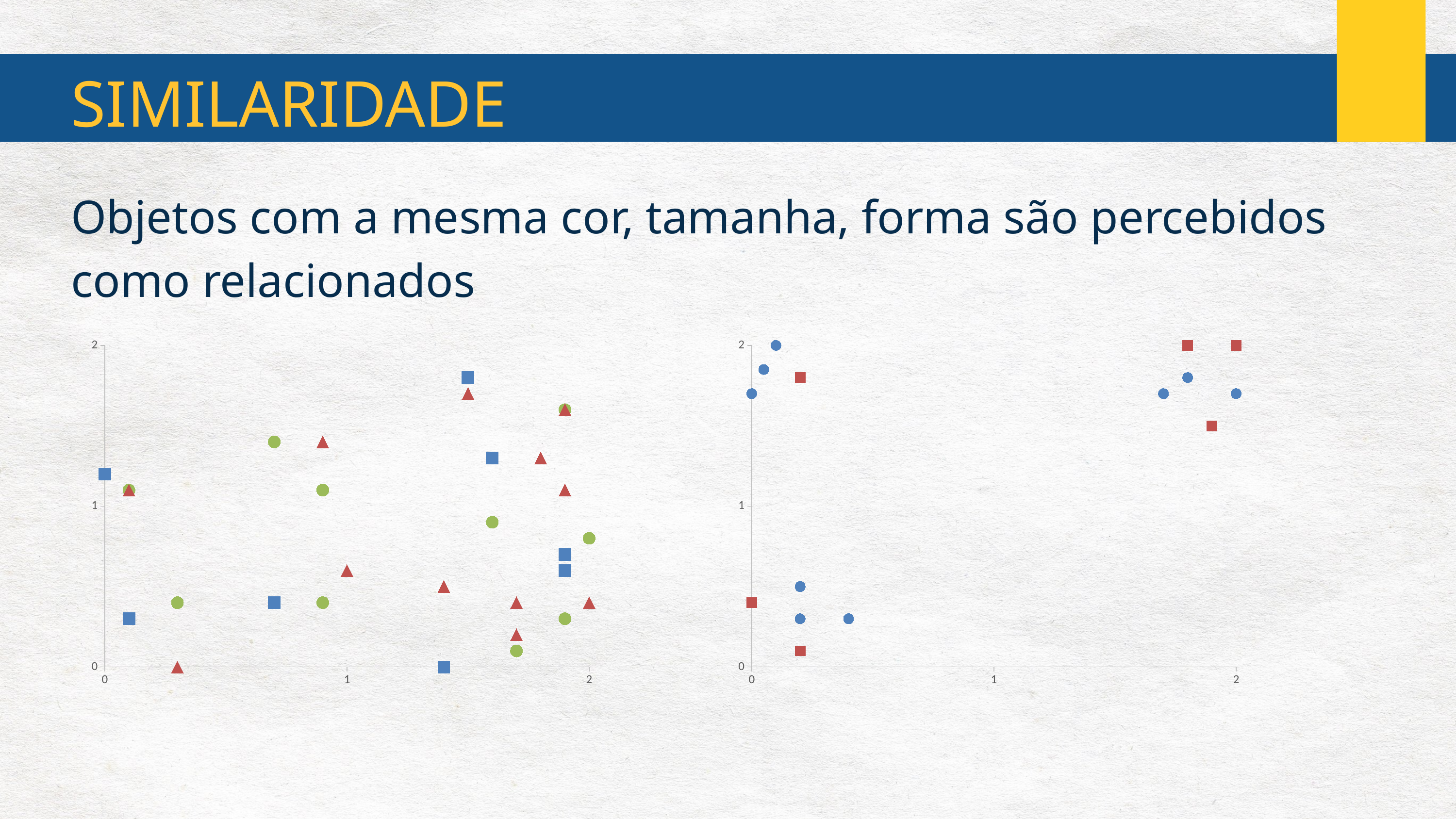
In the right chart, is the y value of the lowest red square greater or less than 1? less In the right chart, how many blue circle markers are plotted? 9 In the right chart, how many red square markers are plotted? 6 In the right chart, what is the highest value shown on the x axis? 2 In the left chart, is the y value of the highest blue square greater or less than 1? greater In the right chart, how many different marker shapes are plotted? 2 In the left chart, which marker shape appears in green? circle In the left chart, what is the highest value shown on the y axis? 2 What kind of chart is the chart on the left of the slide? scatter chart In the left chart, how many different marker shapes are plotted? 3 What kind of chart is the chart on the right of the slide? scatter chart In the right chart, is the y value of the highest blue circle greater or less than 1? greater